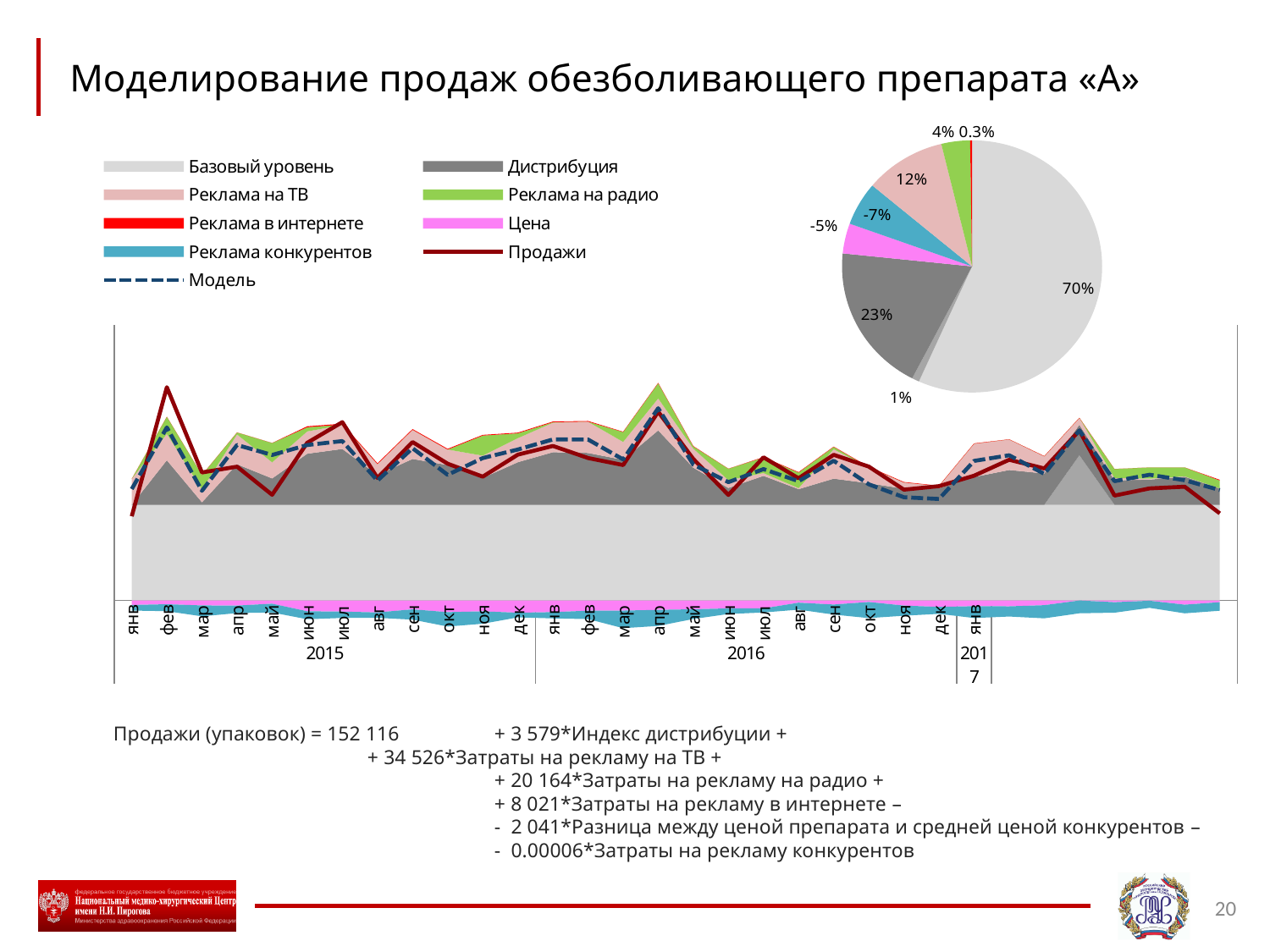
In the pie chart, what value is shown for the green slice? 4% How many entries does the legend of the main chart list? 9 In the pie chart, what value is shown for the pink slice? 12% Which years are shown on the x axis of the main chart? 2015, 2016, 2017 In the pie chart, what value is shown for the magenta slice? -5% In the pie chart, what is the difference between the 70% slice and the 23% slice? 47 percentage points In the pie chart, what value is shown for the dark grey slice? 23% How many labelled slices does the pie chart have? 8 In the pie chart, what is the value of the smallest labelled slice? 0.3% In the pie chart, what is the value of the largest slice? 70% In the pie chart, what value is shown for the blue slice? -7% In the pie chart, which is larger: the pink slice or the green slice? The pink slice (12%)